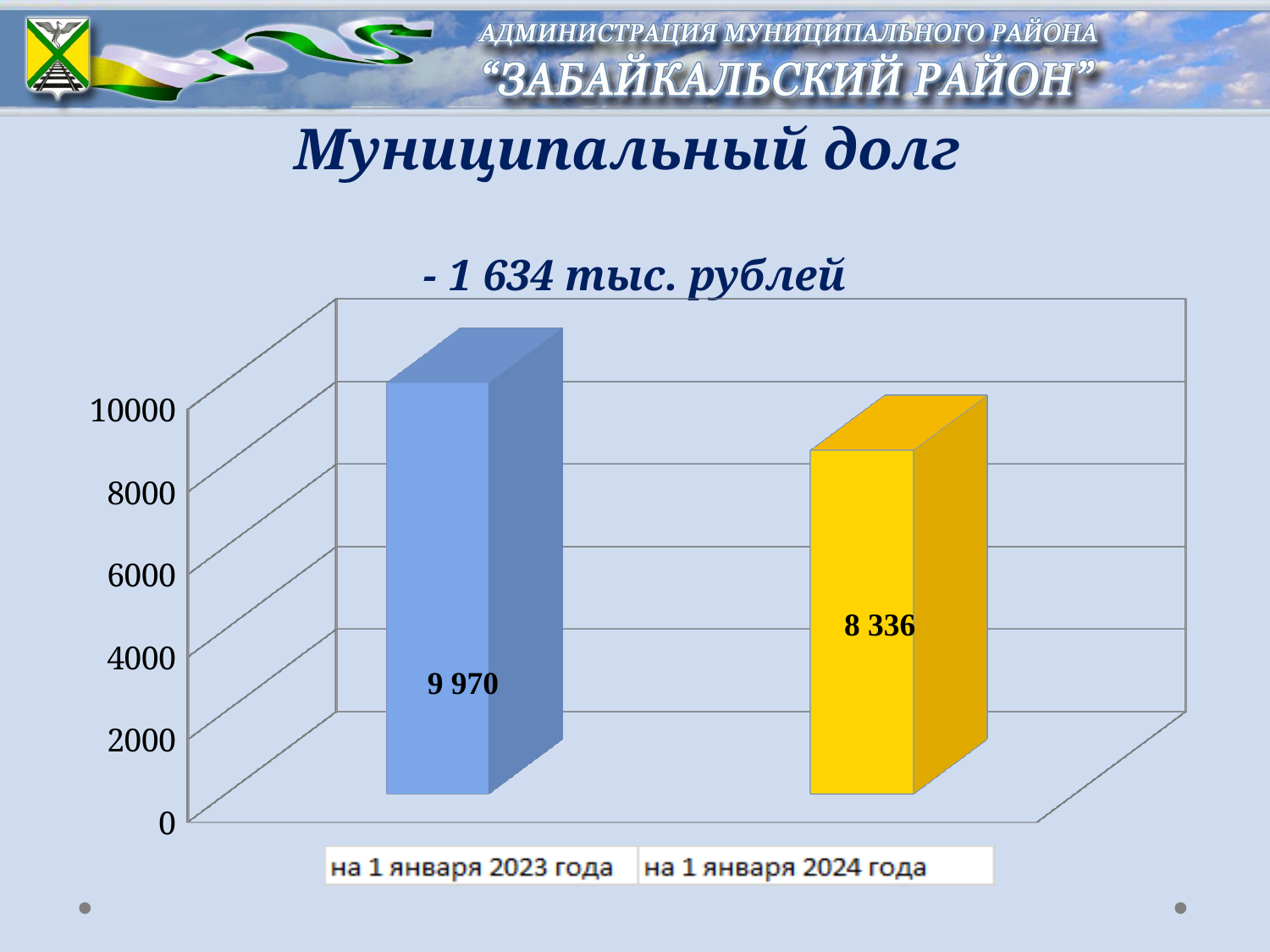
Is the value for 1 January 2024 greater or less than 10000? less What kind of chart is shown on the slide? bar chart Is the value for 1 January 2023 larger or smaller than the value for 1 January 2024? larger Do the values rise or fall from 1 January 2023 to 1 January 2024? fall How many bars are plotted in the chart? 2 What is the difference between the value for 1 January 2023 and the value for 1 January 2024? 1 634 Which date has the lower municipal debt value? на 1 января 2024 года What is the title of the chart on the slide? Муниципальный долг What is the municipal debt value shown for 1 January 2024 (на 1 января 2024 года)? 8 336 What is the municipal debt value shown for 1 January 2023 (на 1 января 2023 года)? 9 970 What colour is the bar for 1 January 2024? yellow Which date has the higher municipal debt value? на 1 января 2023 года